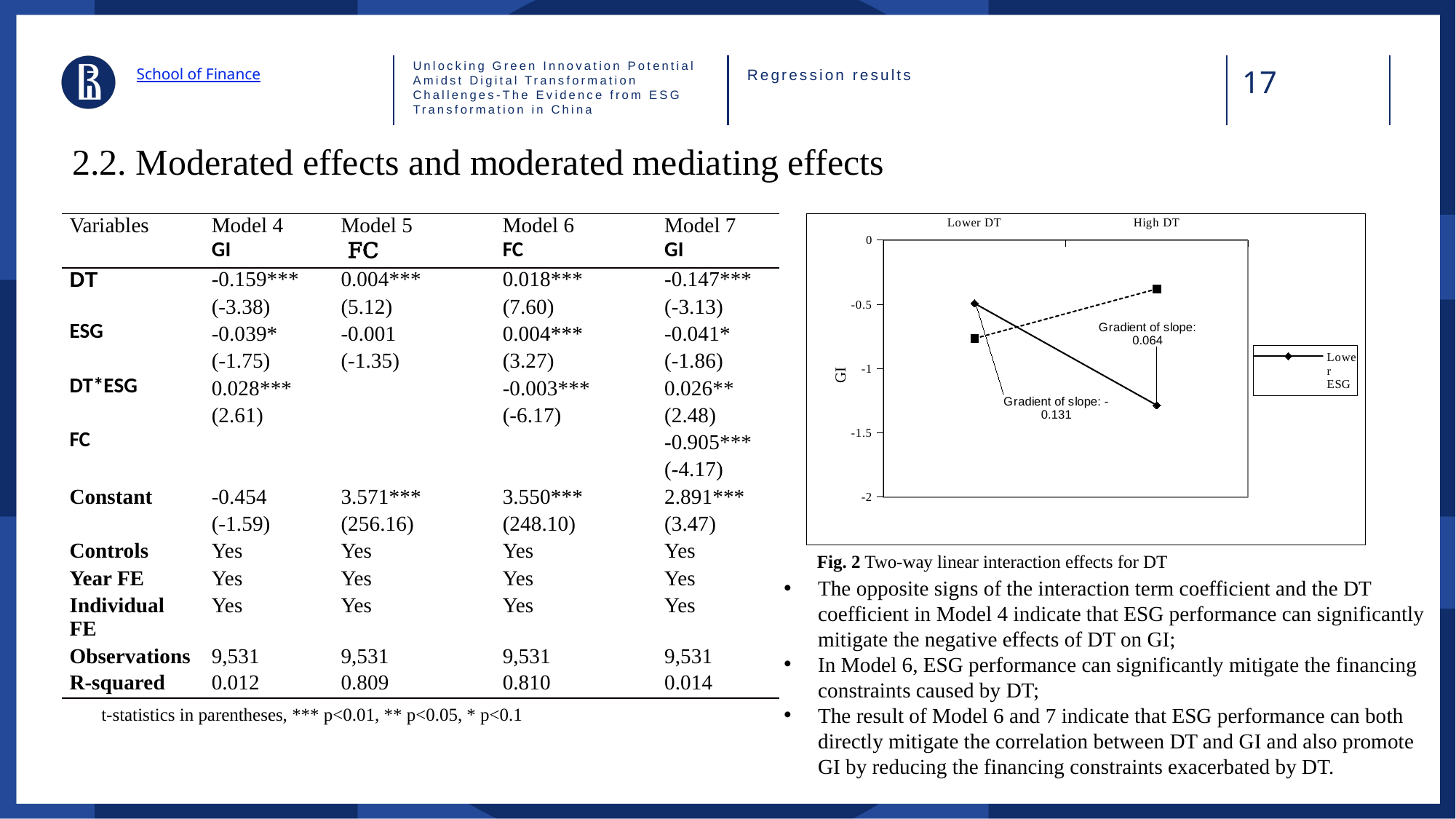
How many x-axis categories does the Fig. 2 chart show? 2 In the Fig. 2 chart, what is the gradient of slope printed for the dashed line? 0.064 In the Fig. 2 chart, is the Lower ESG value at Lower DT greater or less than -1? greater In the Fig. 2 chart, is the Lower ESG value at High DT greater or less than -1? less In the Fig. 2 chart, at High DT, which line has the higher GI value: the solid Lower ESG line or the dashed line? the dashed line In the Fig. 2 chart, at which x-axis category does the Lower ESG line reach its lowest GI value? High DT What is the label on the y-axis of the Fig. 2 chart? GI In the Fig. 2 chart, does the dashed line rise or fall from Lower DT to High DT? rise What is the caption of the chart on the slide? Fig. 2 Two-way linear interaction effects for DT What kind of chart is shown in Fig. 2 on the slide? line chart In the Fig. 2 chart, does the solid Lower ESG line rise or fall from Lower DT to High DT? fall In the Fig. 2 chart, what is the gradient of slope printed for the solid Lower ESG line? -0.131